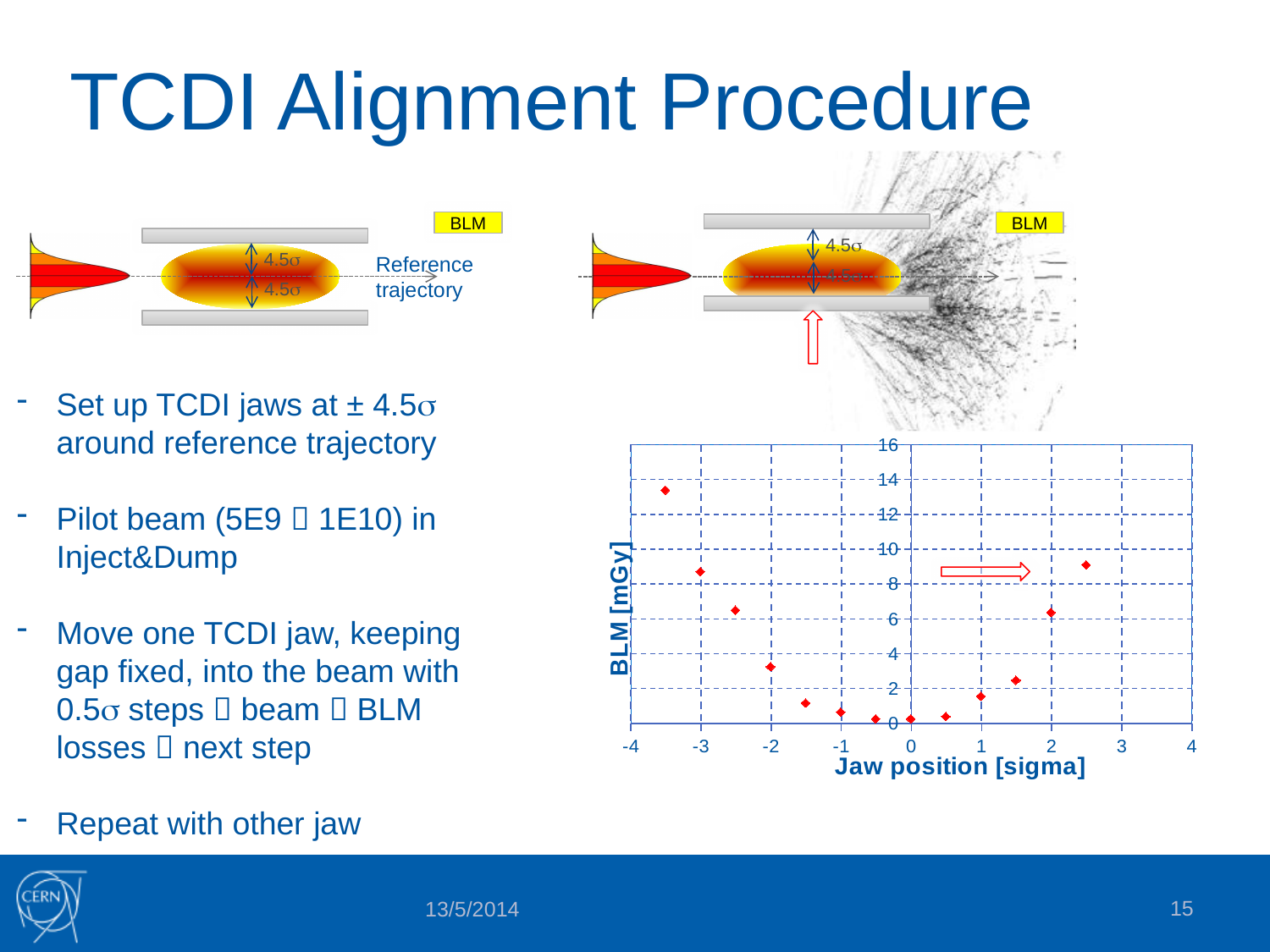
Is the BLM value at jaw position 2.5 greater or less than 8? greater Do the BLM values rise or fall as the jaw position goes from -3.5 to 0? fall At which jaw position is the BLM value highest? -3.5 What kind of chart is shown on the slide? scatter chart Is the BLM value at jaw position 2 greater or less than 8? less Is the BLM value at jaw position -3 greater or less than 10? less Which has the larger BLM value: jaw position -3.5 or jaw position 2.5? -3.5 What is the title of the x axis of the chart? Jaw position [sigma] How many data points are plotted in the chart? 13 What is the title of the y axis of the chart? BLM [mGy]